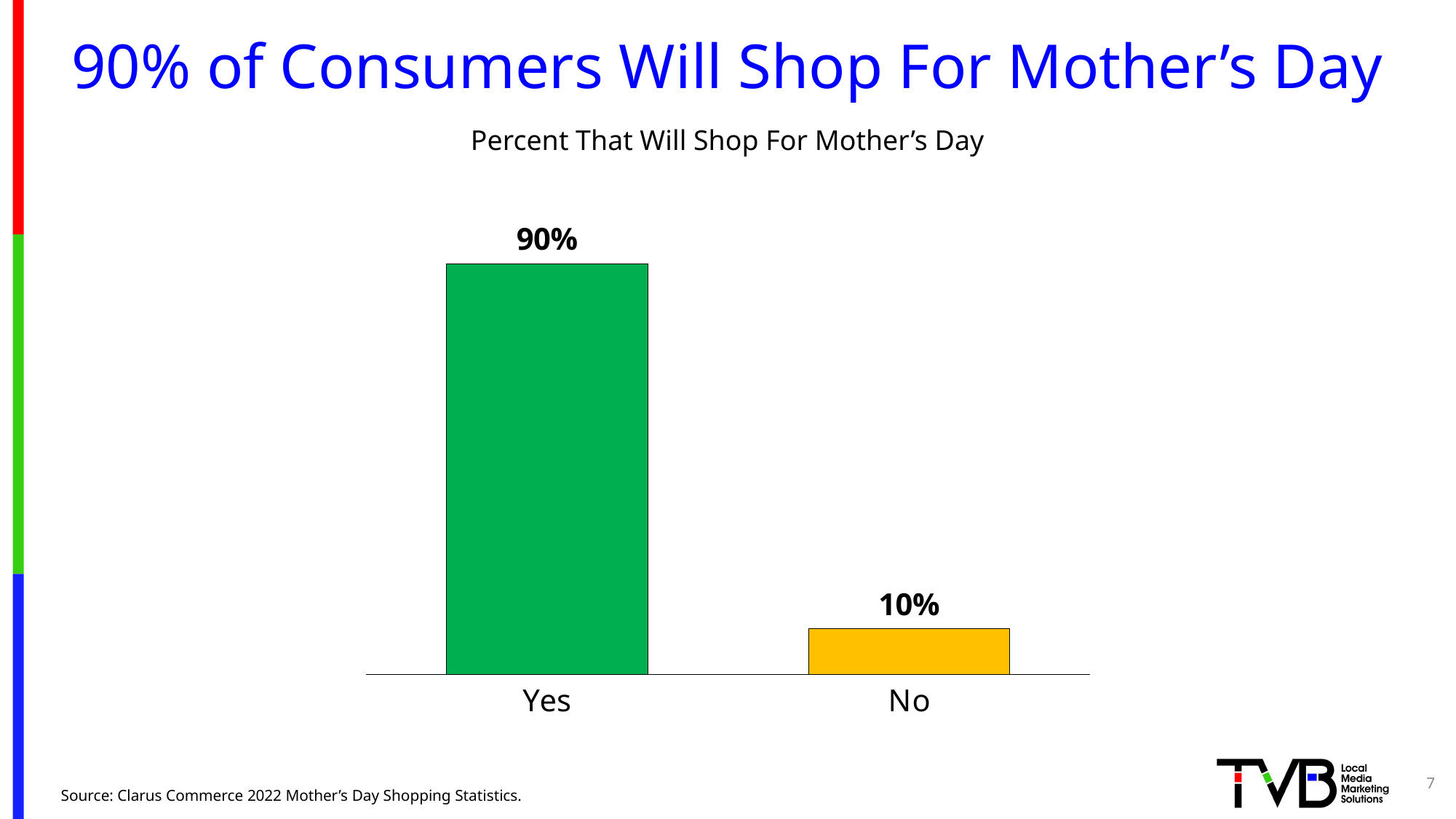
How many categories are shown in the chart? 2 What kind of chart is shown on the slide? Bar chart What is the total of the Yes and No values? 100% What is the title of the chart? Percent That Will Shop For Mother's Day What colour is the bar for Yes? Green Which category has the highest value in the chart? Yes Which is larger, the value for Yes or the value for No? Yes What percent of consumers answered Yes to shopping for Mother's Day? 90% What percent of consumers answered No to shopping for Mother's Day? 10% Which category has the lowest value in the chart? No What is the difference between the Yes and No values? 80%